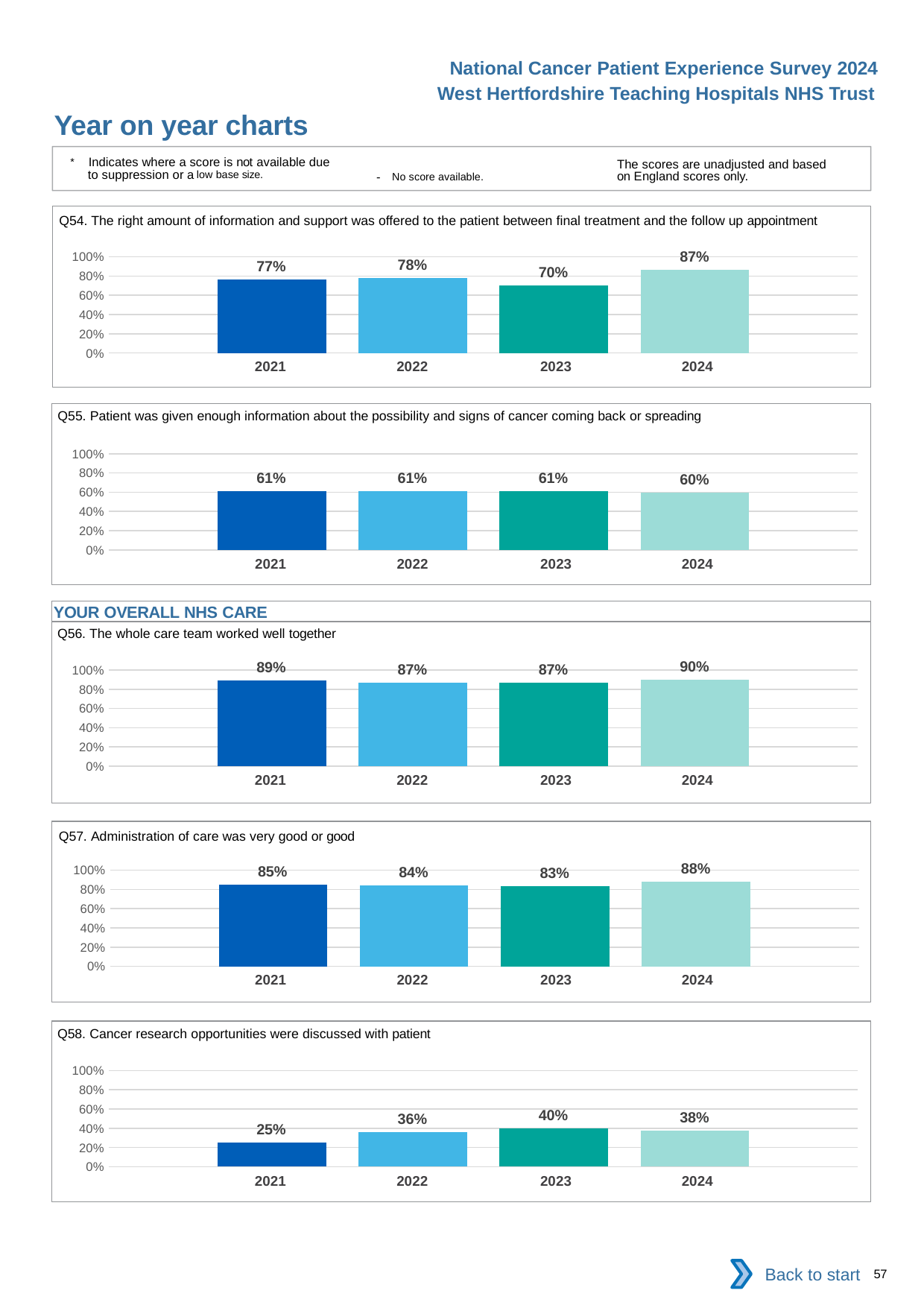
In the Q58 chart, what is the difference between the 2023 value and the 2021 value? 15% In the Q55 chart, how many years are plotted? 4 In the Q57 chart, what is the value for 2023? 83% What kind of chart is the Q58 chart? Bar chart In the Q58 chart, which year has the lowest value? 2021 In the Q55 chart, what is the value for 2024? 60% In the Q56 chart, what is the difference between the 2024 value and the 2021 value? 1% In the Q54 chart, which year has the lowest value? 2023 In the Q54 chart, what is the value for 2024? 87% In the Q57 chart, is the value for 2024 larger than the value for 2021? Yes In the Q54 chart, is the value for 2023 greater or less than 80%? less In the Q56 chart, which year has the highest value? 2024